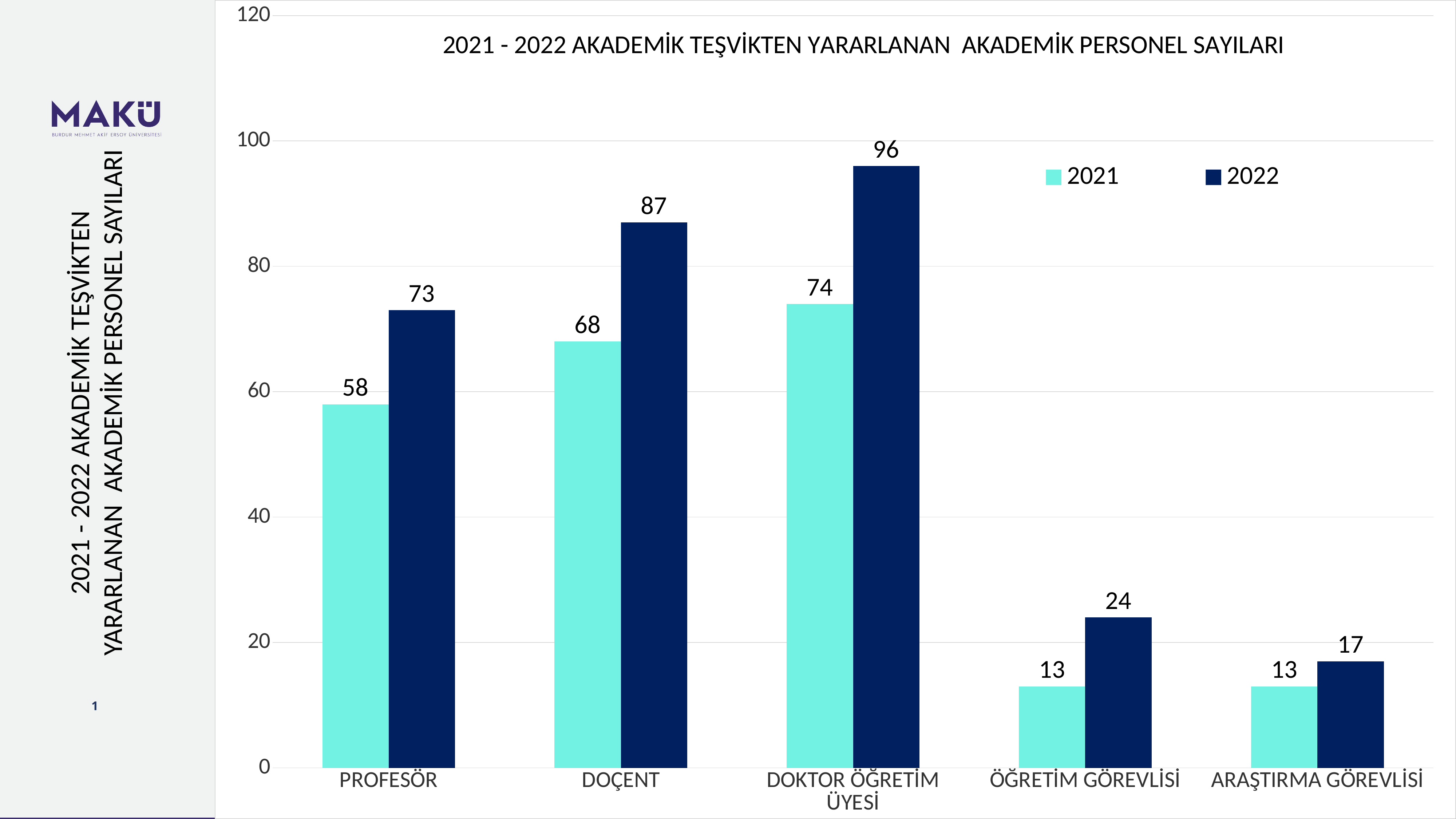
What is the difference between the 2022 and 2021 values for DOKTOR ÖĞRETİM ÜYESİ? 22 Which category has the highest 2022 value? DOKTOR ÖĞRETİM ÜYESİ What is the title of the chart? 2021 - 2022 AKADEMİK TEŞVİKTEN YARARLANAN AKADEMİK PERSONEL SAYILARI How many categories are shown on the x axis? 5 What kind of chart is shown on the slide? Bar chart What is the difference between the 2022 and 2021 values for PROFESÖR? 15 Which category has the lowest 2022 value? ARAŞTIRMA GÖREVLİSİ What is the 2022 value for DOÇENT? 87 What is the 2022 value for ÖĞRETİM GÖREVLİSİ? 24 What is the 2021 value for PROFESÖR? 58 Which is larger, the 2021 value for DOÇENT or the 2022 value for PROFESÖR? 2022 value for PROFESÖR How many series does the legend list? 2